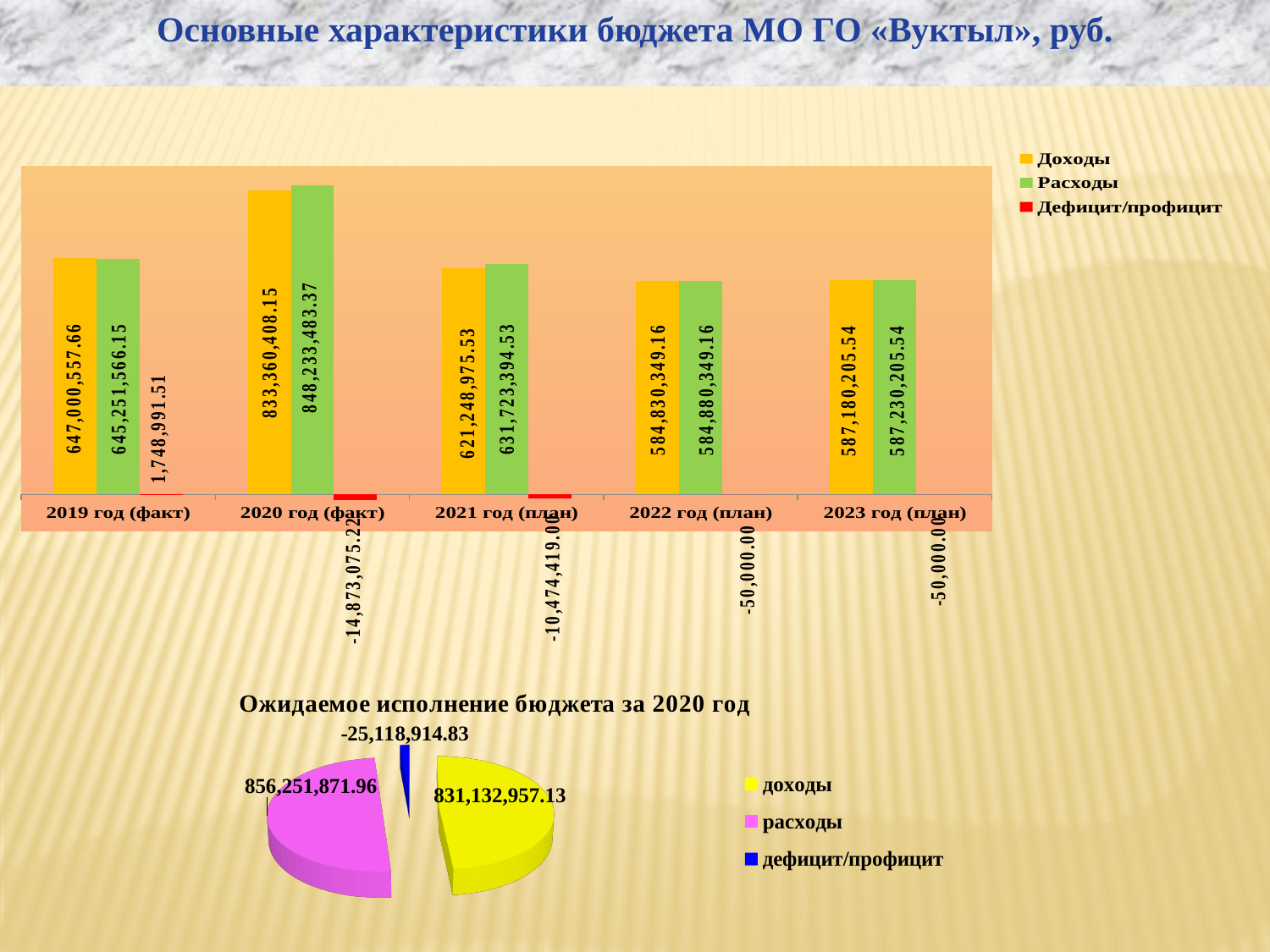
In the bottom pie chart, what is the value of расходы? 856,251,871.96 What kind of chart is the bottom chart titled «Ожидаемое исполнение бюджета за 2020 год»? Pie chart In the top bar chart, what is the value of Доходы for 2020 год (факт)? 833,360,408.15 How many series does the legend of the top bar chart list? 3 In the top bar chart, what is the difference between Расходы and Доходы for 2020 год (факт)? 14,873,075.22 In the top bar chart, which is larger for 2019 год (факт): Доходы or Расходы? Доходы In the top bar chart, which year has the highest Доходы? 2020 год (факт) How many year categories does the top bar chart show? 5 In the top bar chart, what is the value of Расходы for 2021 год (план)? 631,723,394.53 In the top bar chart, which year has the lowest Расходы? 2022 год (план) In the bottom pie chart, what is the value of дефицит/профицит? -25,118,914.83 In the top bar chart, what is the value of Дефицит/профицит for 2019 год (факт)? 1,748,991.51